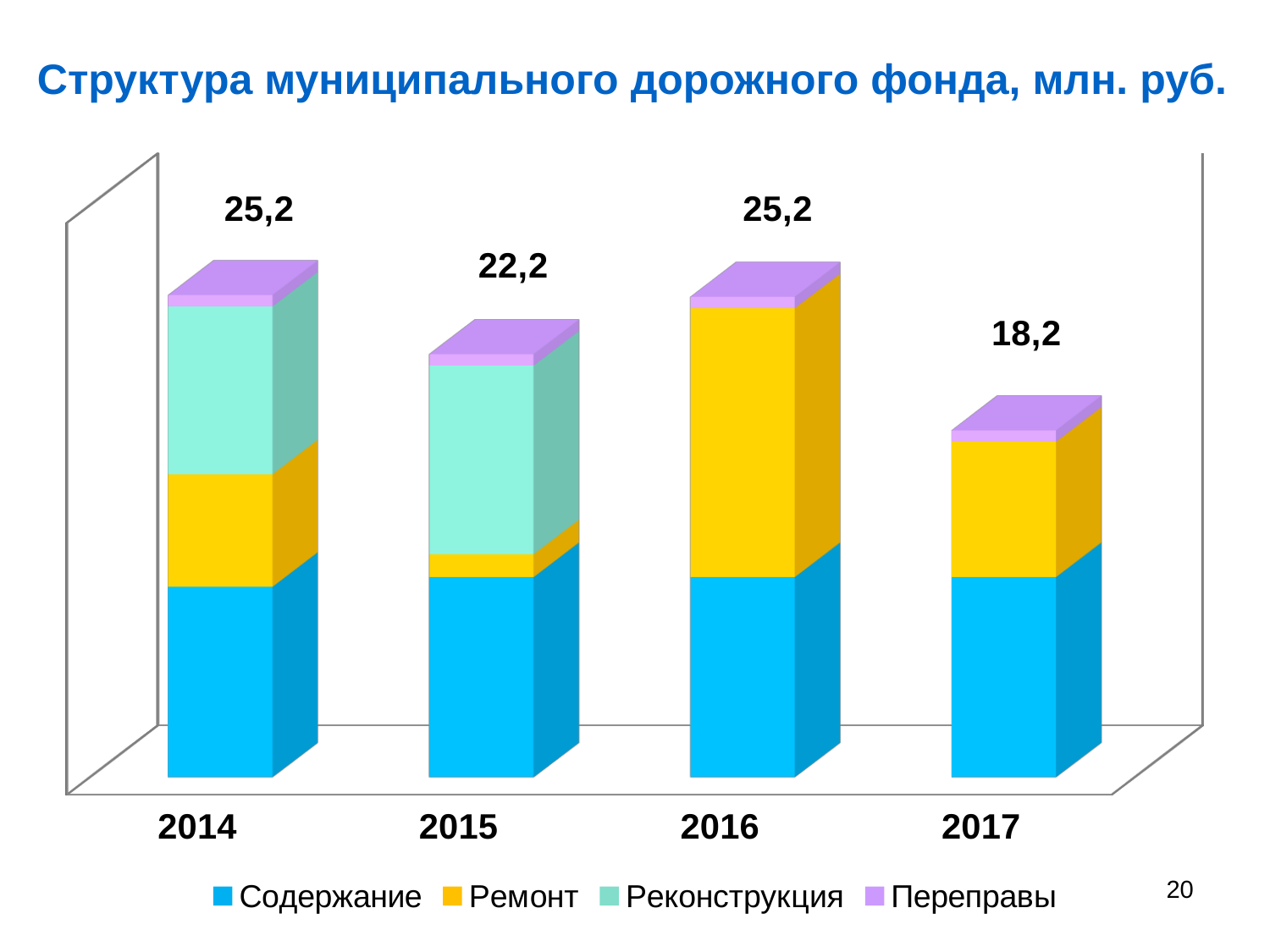
What is the difference between the total for 2016 and the total for 2017? 7 What is the title of the chart? Структура муниципального дорожного фонда, млн. руб. Which year has the lowest total value? 2017 What is the total value of the bar for 2015? 22,2 What is the difference between the total for 2014 and the total for 2015? 3 What is the total value of the bar for 2014? 25,2 Which is larger, the total for 2015 or the total for 2017? 2015 How many series does the legend list? 4 What kind of chart is shown on the slide? Stacked bar chart What is the total value of the bar for 2017? 18,2 How many years are shown on the x axis? 4 Which series is shown in yellow in the legend? Ремонт